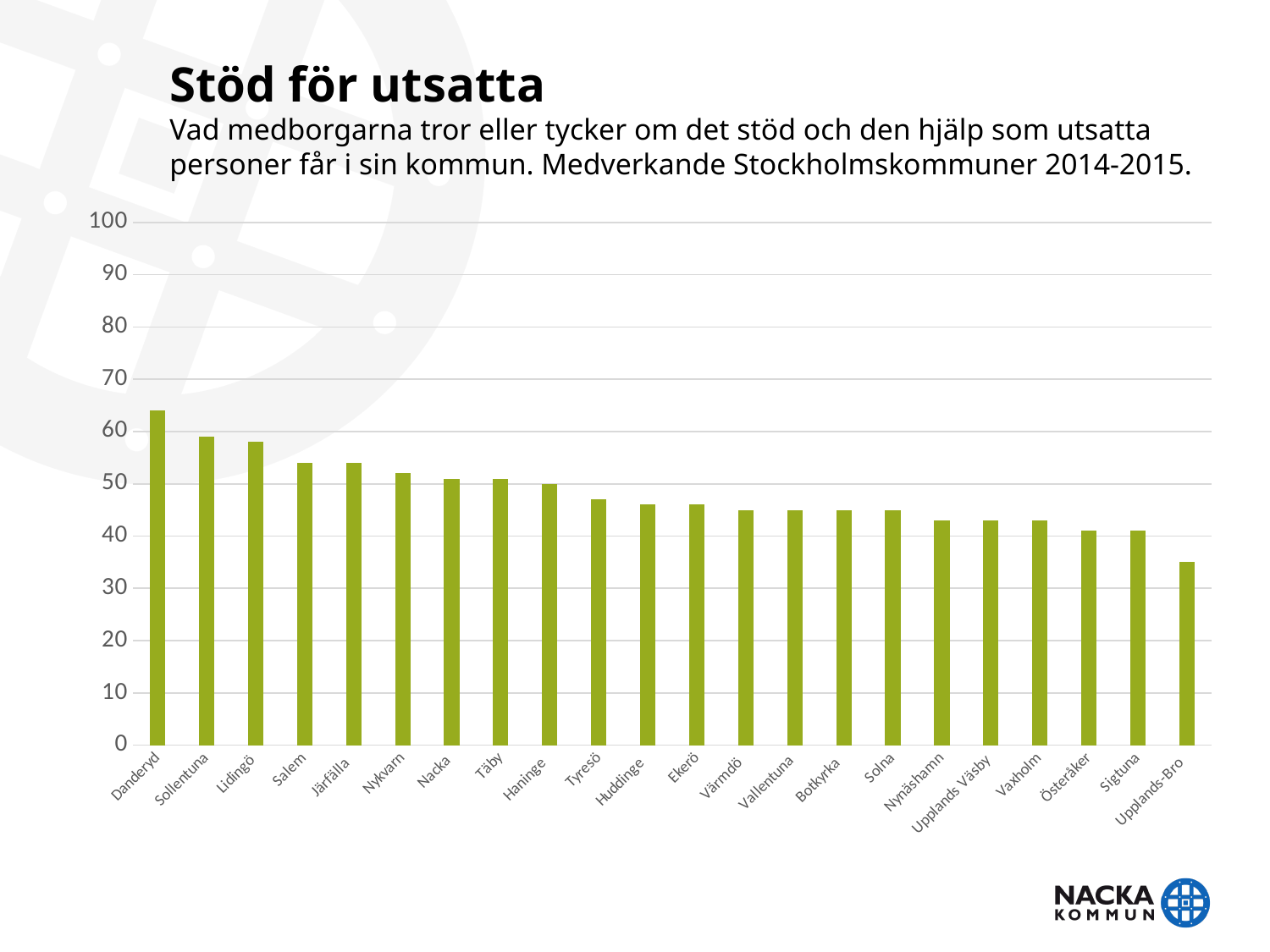
Is the value for Danderyd greater or less than 60? greater Is the value for Upplands-Bro greater or less than 40? less What kind of chart is shown on the slide? bar chart Which municipality has the highest value in the chart? Danderyd Which municipality has the lowest value in the chart? Upplands-Bro Is the value for Nacka greater or less than 40? greater Which has a larger value, Upplands-Bro or Salem? Salem Do the values rise or fall from left to right along the x axis? fall Which has a larger value, Lidingö or Sigtuna? Lidingö How many municipalities are shown in the chart? 22 What is the title of the chart on the slide? Stöd för utsatta